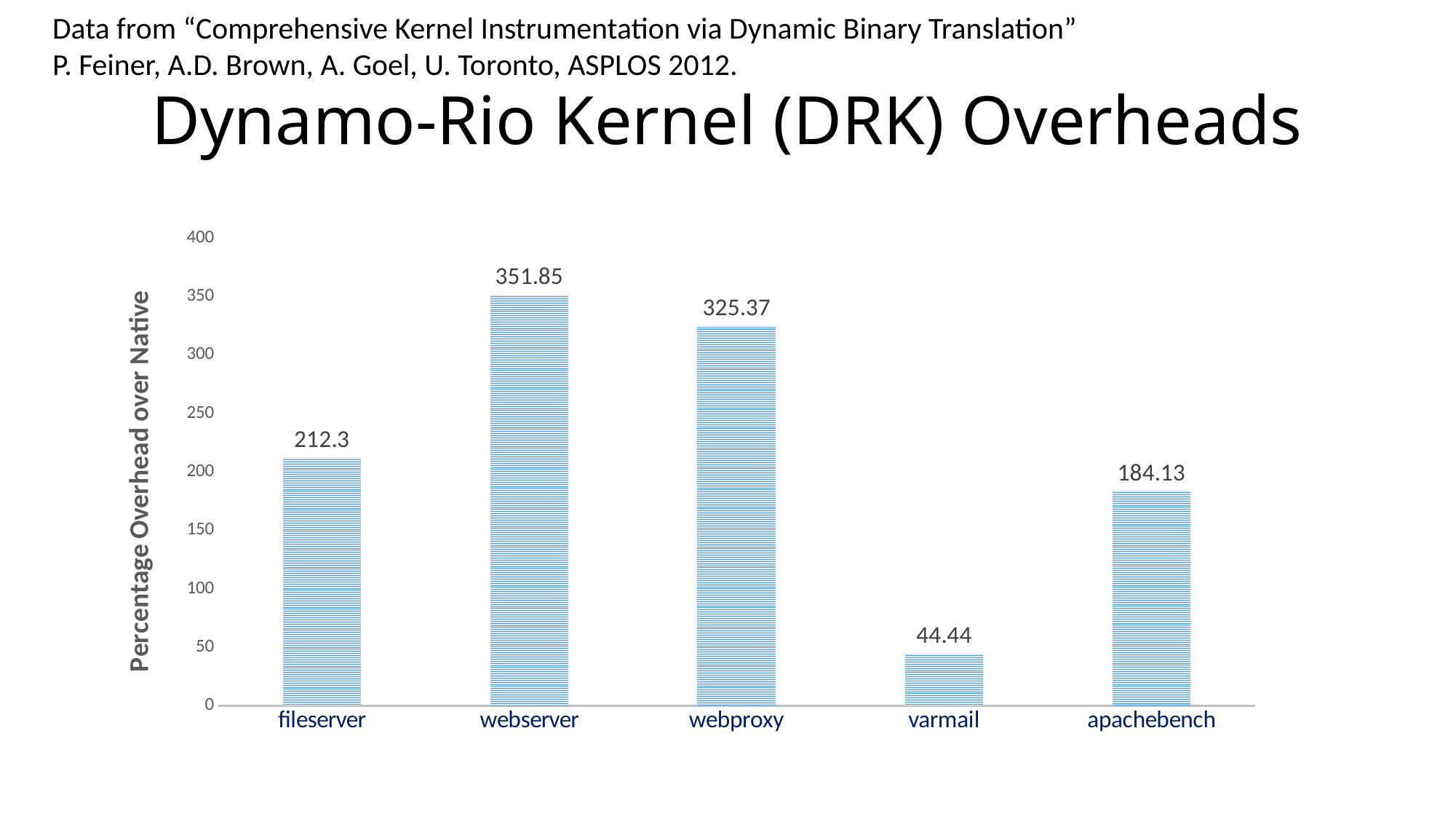
How many benchmarks are shown on the x axis? 5 What is the percentage overhead over native for apachebench? 184.13 Which has a larger percentage overhead, fileserver or apachebench? fileserver Is the value for webproxy greater or less than 300? greater What is the percentage overhead over native for varmail? 44.44 What is the difference in percentage overhead between fileserver and apachebench? 28.17 What is the percentage overhead over native for webserver? 351.85 What kind of chart is shown on the slide? bar chart Which benchmark has the lowest percentage overhead over native? varmail What is the difference in percentage overhead between webserver and webproxy? 26.48 What is the label of the y axis? Percentage Overhead over Native Which benchmark has the highest percentage overhead over native? webserver